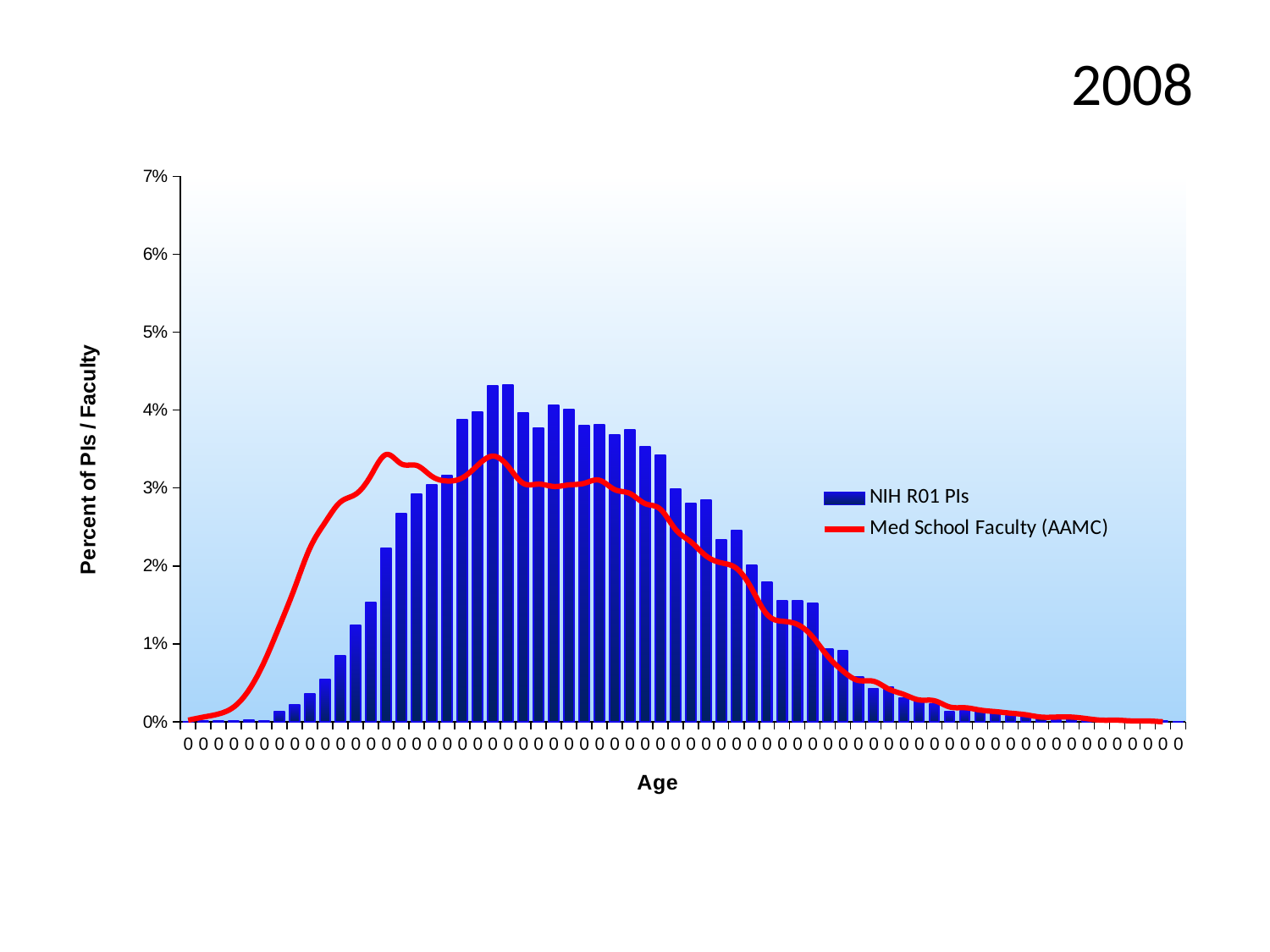
Is the tallest NIH R01 PIs bar greater or less than 4%? greater Is the tallest NIH R01 PIs bar greater or less than 5%? less How many series does the legend list? 2 What are the two series named in the legend? NIH R01 PIs and Med School Faculty (AAMC) What kind of chart is shown on the slide? bar chart with a line overlay Is the peak of the Med School Faculty (AAMC) line greater or less than 4%? less Which series reaches a higher peak value, NIH R01 PIs or Med School Faculty (AAMC)? NIH R01 PIs What is the title of the vertical axis? Percent of PIs / Faculty